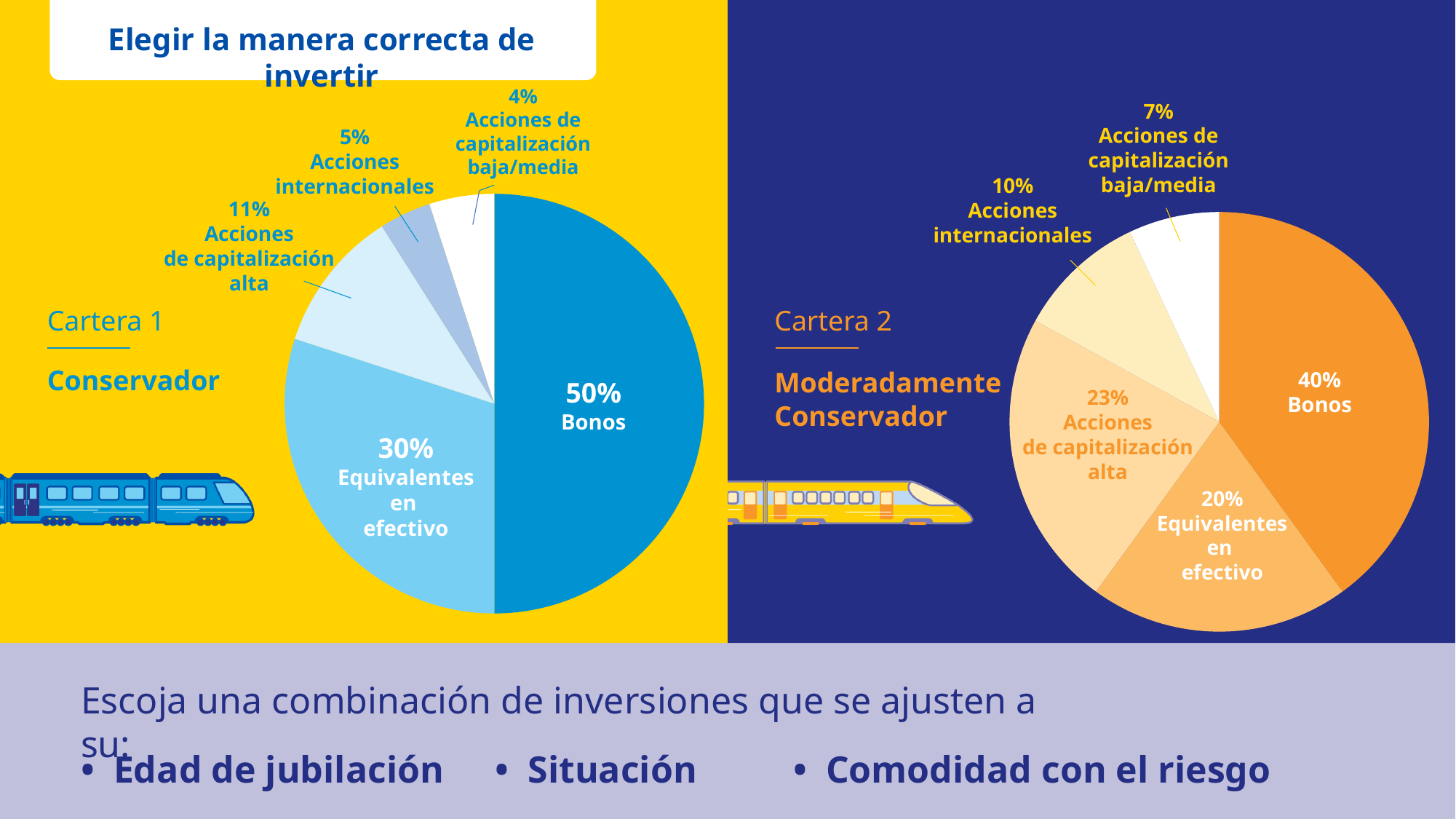
In the Cartera 1 (Conservador) pie chart, which category has the smallest share? Acciones de capitalización baja/media In the Cartera 1 (Conservador) pie chart, what is the difference between Bonos and Equivalentes en efectivo? 20% In the Cartera 1 (Conservador) pie chart, what share is Bonos? 50% What type of chart is used for Cartera 1 and Cartera 2? Pie chart In the Cartera 2 (Moderadamente Conservador) pie chart, which is larger: Equivalentes en efectivo or Acciones de capitalización alta? Acciones de capitalización alta In the Cartera 2 (Moderadamente Conservador) pie chart, which category has the largest share? Bonos In the Cartera 2 (Moderadamente Conservador) pie chart, what share is Acciones de capitalización alta? 23% In the Cartera 2 (Moderadamente Conservador) pie chart, what is the difference between Bonos and Acciones de capitalización baja/media? 33% In the Cartera 2 (Moderadamente Conservador) pie chart, what share is Acciones internacionales? 10% In the Cartera 1 (Conservador) pie chart, what share is Equivalentes en efectivo? 30% What is the title of the slide containing the two pie charts? Elegir la manera correcta de invertir In the Cartera 1 (Conservador) pie chart, how many slices are there? 5